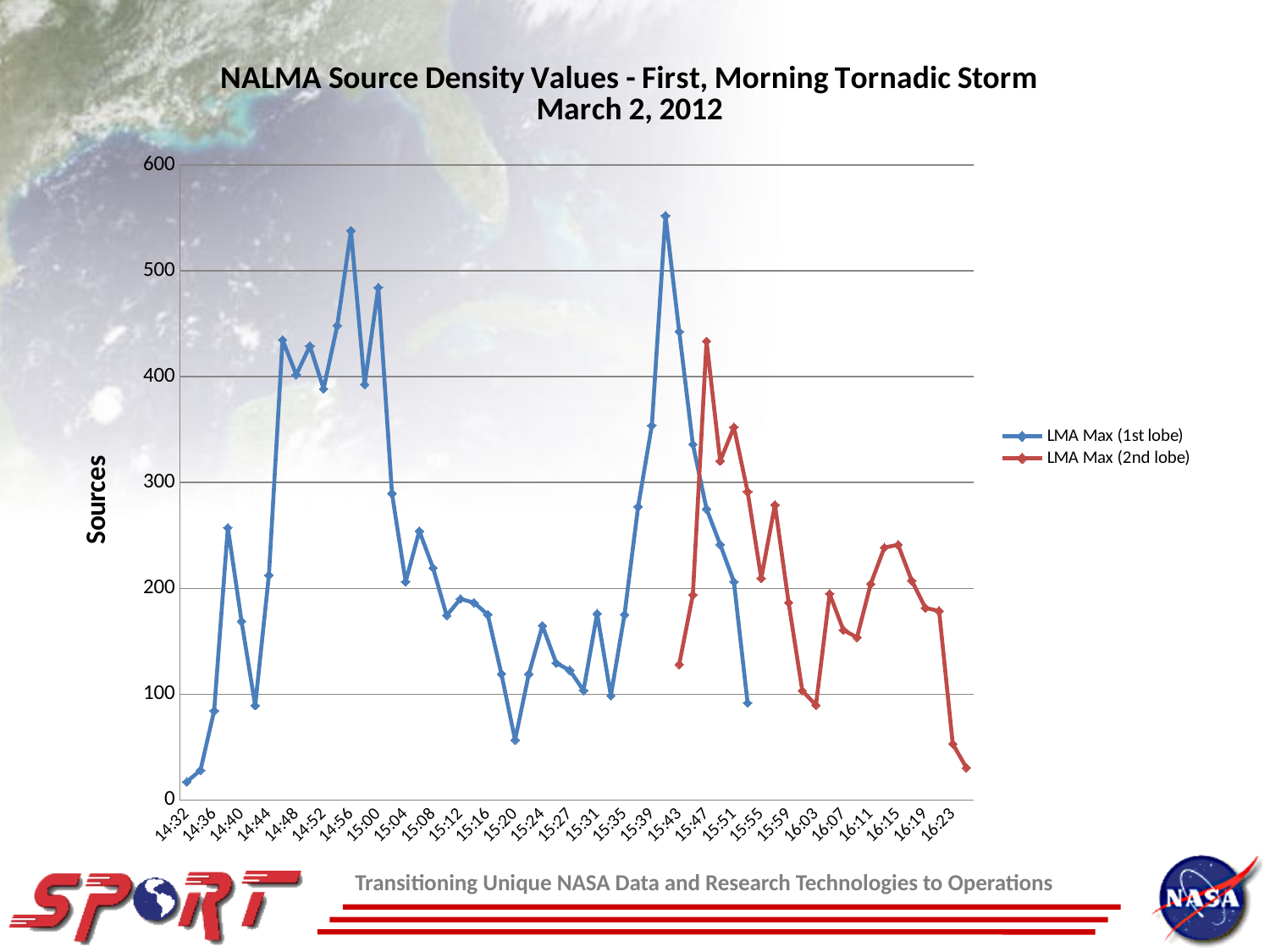
Is the value for LMA Max (1st lobe) at 14:32 greater or less than 100? less What is the title of the chart? NALMA Source Density Values - First, Morning Tornadic Storm March 2, 2012 Which series is drawn in red? LMA Max (2nd lobe) Does the LMA Max (2nd lobe) series rise or fall between 16:15 and 16:23? fall Does the LMA Max (1st lobe) series rise or fall between 14:32 and 14:48? rise What kind of chart is shown on the slide? line chart Is the highest value of the LMA Max (1st lobe) series greater or less than 500? greater What is the label on the vertical axis? Sources Is the highest value of the LMA Max (2nd lobe) series greater or less than 400? greater Which series reaches the higher peak value, LMA Max (1st lobe) or LMA Max (2nd lobe)? LMA Max (1st lobe) How many series does the legend list? 2